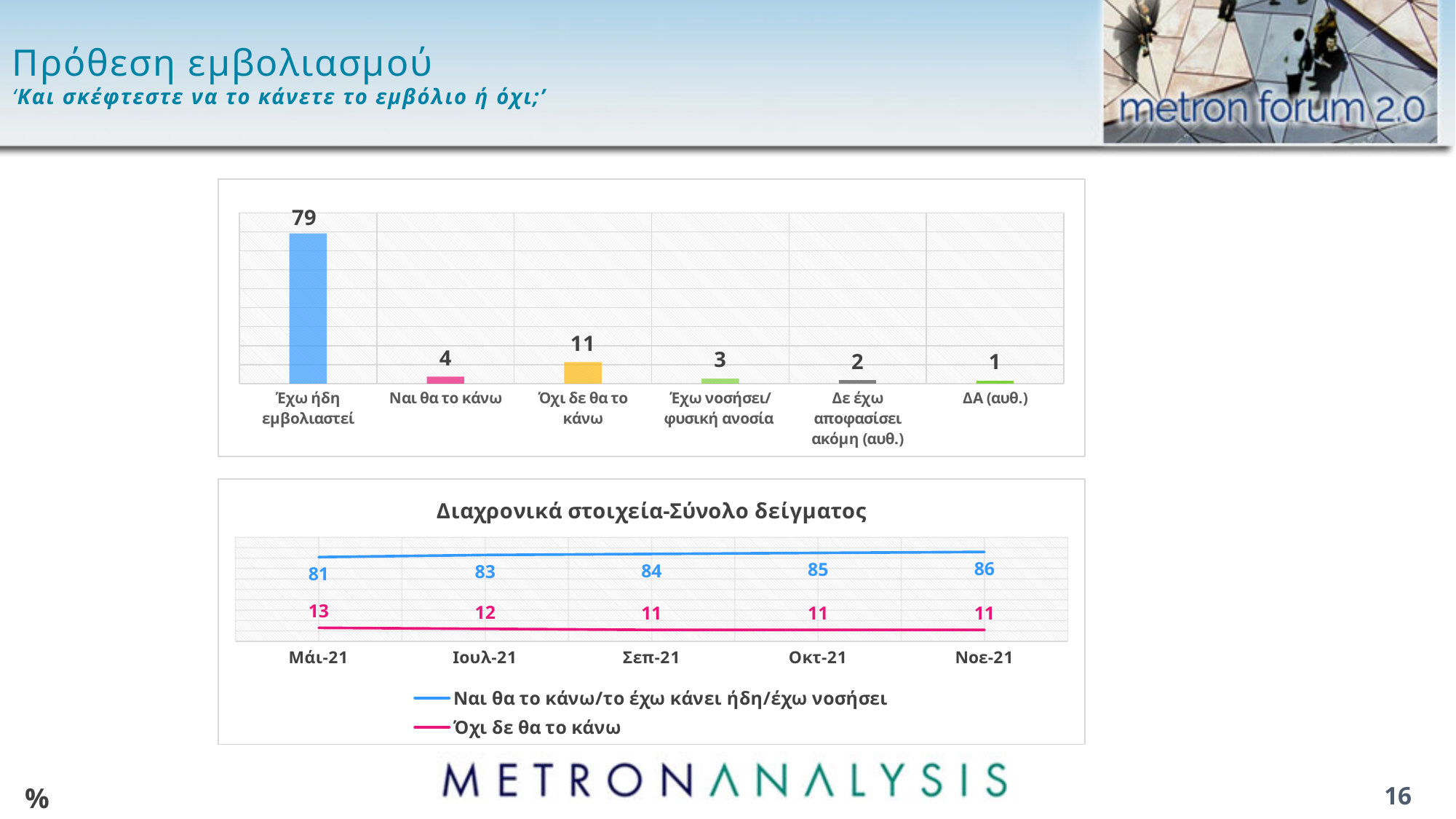
In the top bar chart, what is the value for 'Όχι δε θα το κάνω'? 11 In the chart 'Διαχρονικά στοιχεία-Σύνολο δείγματος', does the 'Ναι θα το κάνω/το έχω κάνει ήδη/έχω νοσήσει' series rise or fall from Μάι-21 to Νοε-21? Rise In the chart 'Διαχρονικά στοιχεία-Σύνολο δείγματος', what is the difference between the two series in Ιουλ-21? 71 In the top bar chart, which category has the highest value? Έχω ήδη εμβολιαστεί In the top bar chart, how many categories are shown? 6 In the chart 'Διαχρονικά στοιχεία-Σύνολο δείγματος', what is the value of 'Ναι θα το κάνω/το έχω κάνει ήδη/έχω νοσήσει' for Νοε-21? 86 In the top bar chart, what is the value for 'Έχω ήδη εμβολιαστεί'? 79 How many series does the legend of the chart 'Διαχρονικά στοιχεία-Σύνολο δείγματος' list? 2 What kind of chart is the top chart on the slide? Bar chart In the top bar chart, which category has the lowest value? ΔΑ (αυθ.) In the chart 'Διαχρονικά στοιχεία-Σύνολο δείγματος', what is the value of 'Όχι δε θα το κάνω' for Μάι-21? 13 In the top bar chart, what is the difference between 'Έχω ήδη εμβολιαστεί' and 'Όχι δε θα το κάνω'? 68